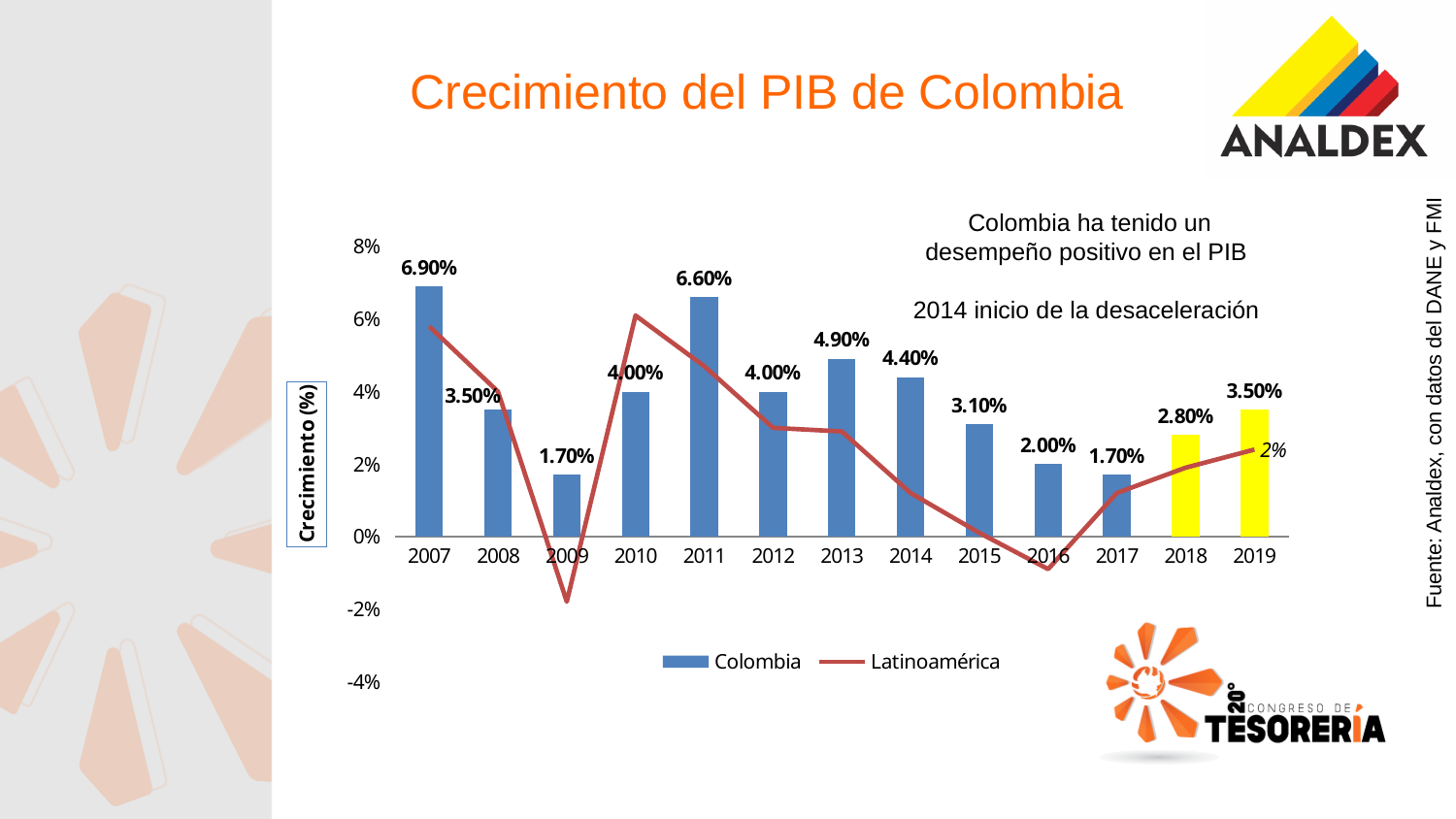
What kind of chart is shown on the slide? A bar chart combined with a line chart In which year does Colombia have the highest GDP growth? 2007 What is the difference between Colombia's growth in 2007 and in 2008? 3.40% What is the GDP growth value for Colombia in 2011? 6.60% How many years are shown on the x axis? 13 How many series does the legend list? 2 Is the Latinoamérica value for 2010 greater or less than 4%? greater Do Colombia's growth values rise or fall from 2011 to 2017? fall What is the value shown for Latinoamérica in 2019? 2% Is the Latinoamérica value for 2016 greater or less than 0%? less Which year has the higher Colombia growth value, 2013 or 2014? 2013 What is the GDP growth value for Colombia in 2007? 6.90%